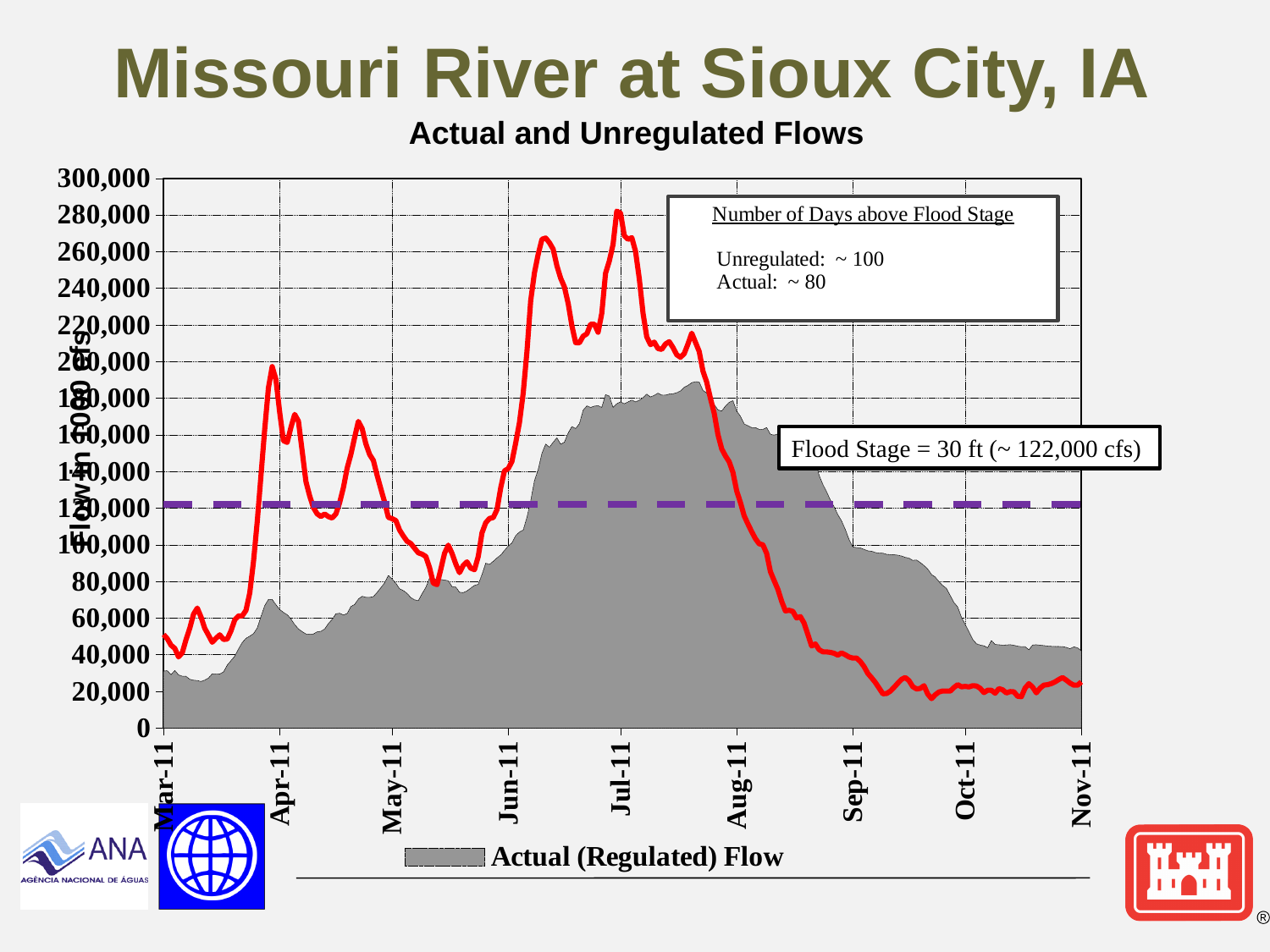
Is the highest point of the red line greater or less than 260,000? greater How many month labels are shown on the x axis? 9 According to the text box, how many days was the unregulated flow above flood stage? ~ 100 Is the red line at Nov-11 greater or less than 40,000? less Which reaches a higher peak, the red line or the gray Actual (Regulated) Flow area? the red line Is the highest point of the gray Actual (Regulated) Flow area greater or less than 200,000? less What kind of chart is shown on the slide? line and area chart Between Aug-11 and Sep-11, does the red line rise or fall? fall At Oct-11, which is higher, the gray Actual (Regulated) Flow area or the red line? the gray Actual (Regulated) Flow area What is the title of the chart? Missouri River at Sioux City, IA How many series does the legend list? 1 What flow value does the dashed Flood Stage line correspond to? ~ 122,000 cfs